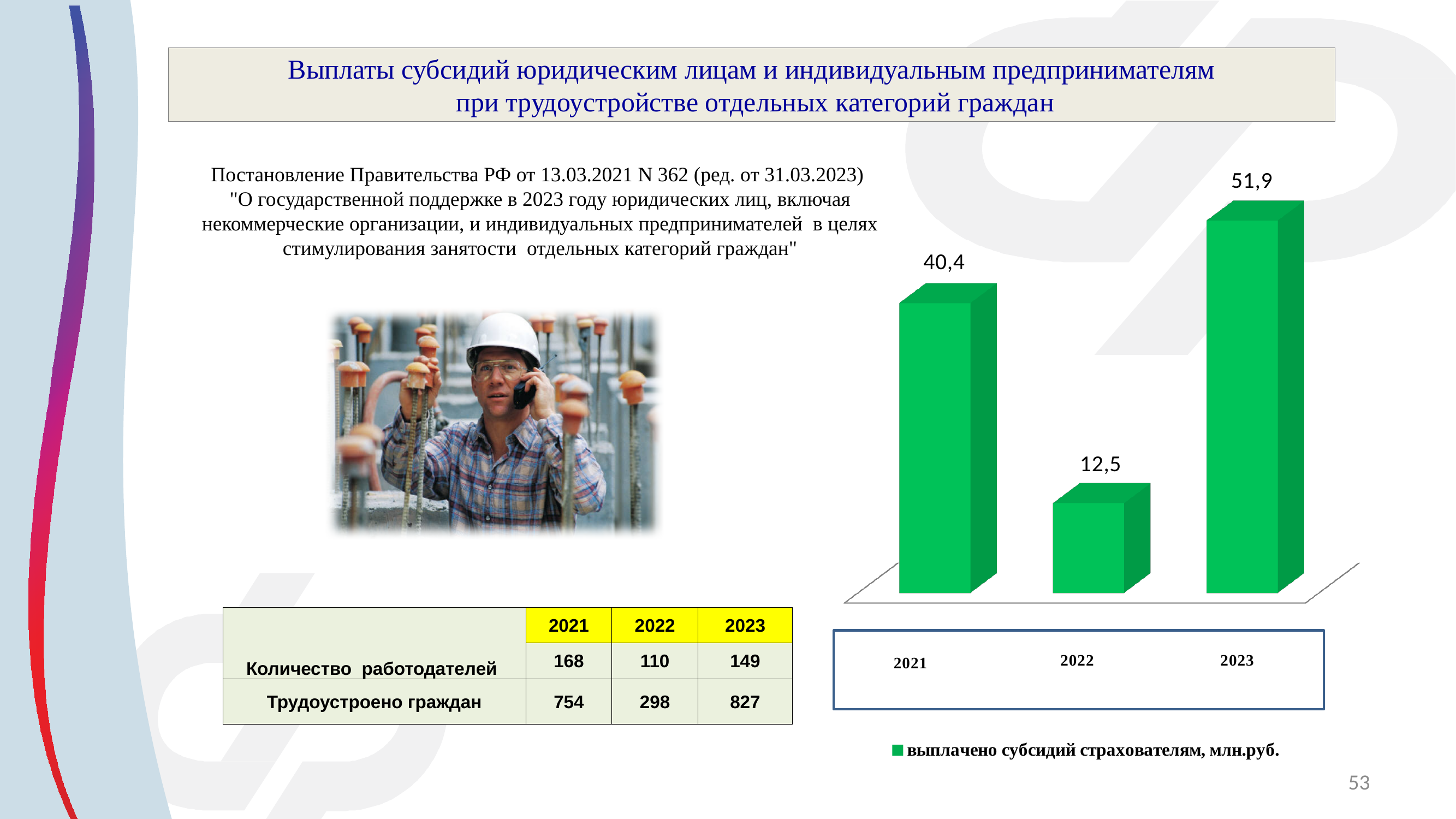
Which year has the highest value in the chart? 2023 Which year has the lowest value in the chart? 2022 How many years (categories) are shown in the chart? 3 What is the difference between the values for 2023 and 2021 in the chart? 11,5 What kind of chart is shown on the slide? Bar chart What is the difference between the values for 2021 and 2022 in the chart? 27,9 What value is shown for 2021 in the chart? 40,4 What is the legend entry of the chart? выплачено субсидий страхователям, млн.руб. What value is shown for 2023 in the chart? 51,9 Which is larger in the chart, the value for 2021 or the value for 2022? 2021 What value is shown for 2022 in the chart? 12,5 How many series does the chart legend list? 1